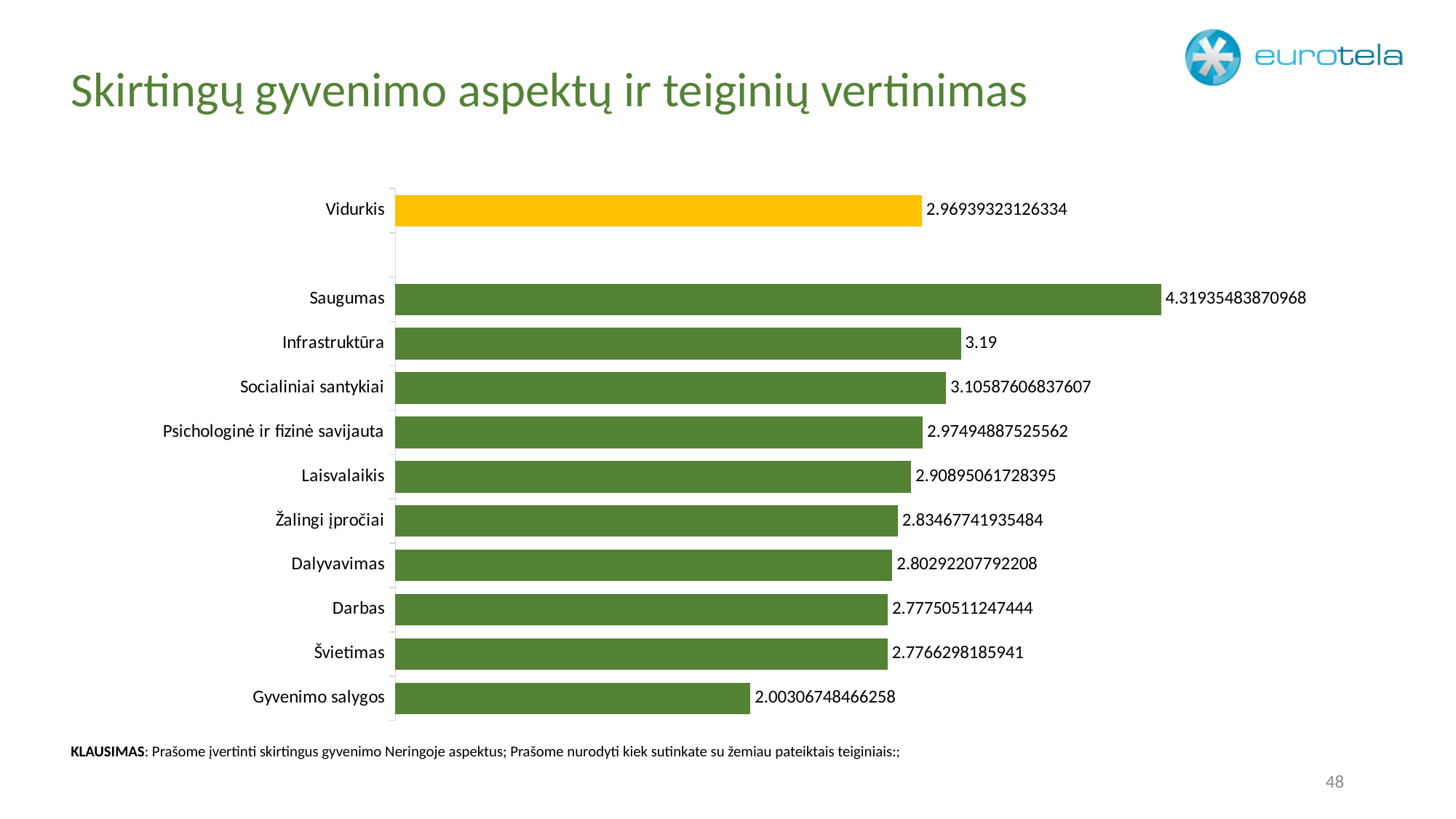
What is the value for Saugumas? 4.31935483870968 What kind of chart is shown on the slide? Bar chart What is the value for Gyvenimo salygos? 2.00306748466258 What colour is the Vidurkis bar? Yellow Which category has the lowest value? Gyvenimo salygos What is the value for Infrastruktūra? 3.19 What is the difference between the values for Infrastruktūra and Gyvenimo salygos? 1.18693251533742 What is the value shown for Vidurkis? 2.96939323126334 How many bars are plotted on the chart? 11 Which is larger, the value for Socialiniai santykiai or the value for Dalyvavimas? Socialiniai santykiai Which category has the highest value? Saugumas Which is larger, the value for Laisvalaikis or the value for Žalingi įpročiai? Laisvalaikis